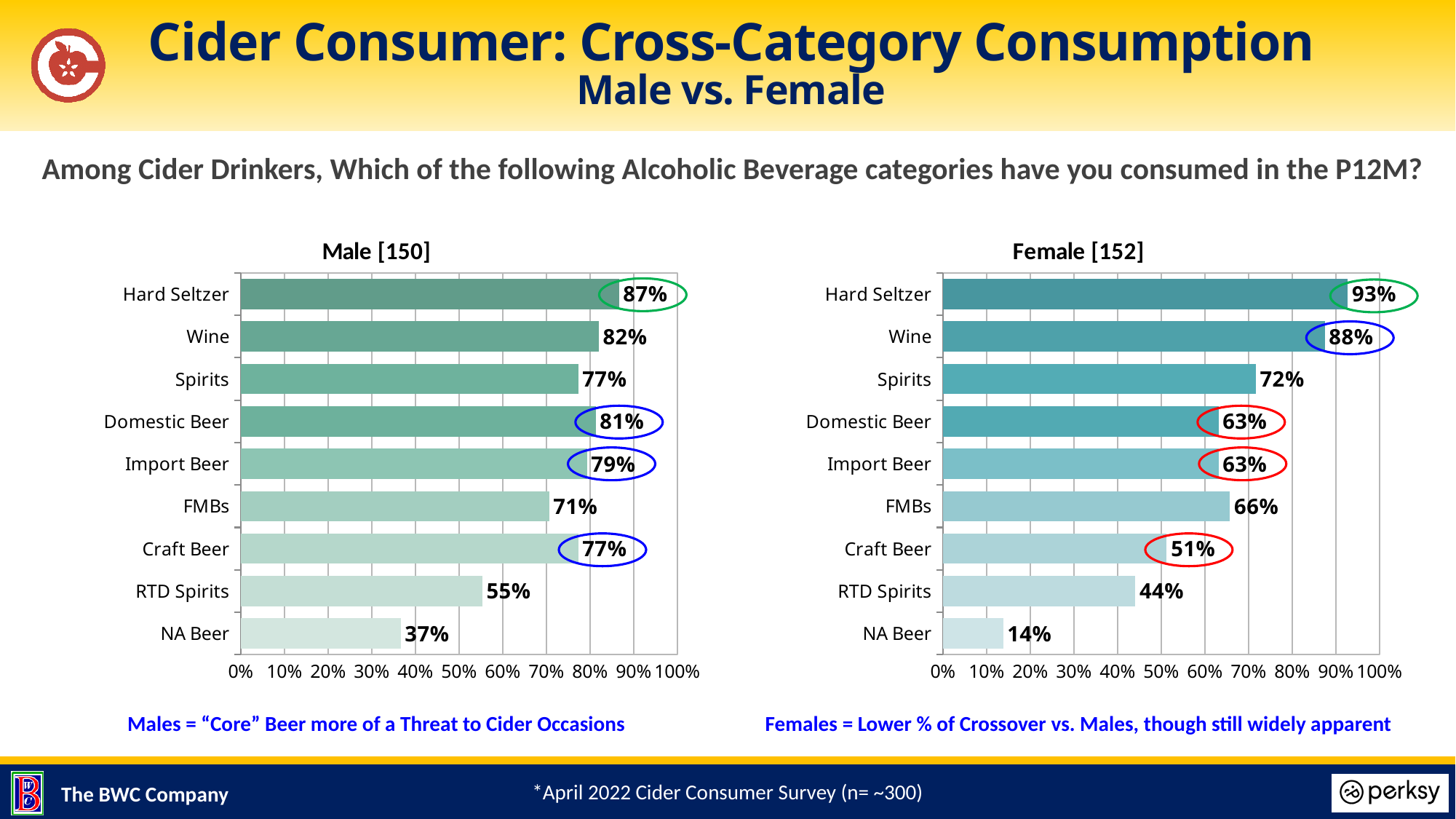
What type of chart is the Female [152] chart? bar chart In the Male [150] chart, what is the value for RTD Spirits? 55% In the Female [152] chart, what is the value for NA Beer? 14% In the Female [152] chart, which category has the lowest value? NA Beer In the Female [152] chart, is the value for RTD Spirits greater or less than 50%? less In the Male [150] chart, what is the difference between Hard Seltzer and NA Beer? 50% In the Male [150] chart, what is the value for Wine? 82% In the Male [150] chart, which category has the highest value? Hard Seltzer How many categories are shown in the Male [150] chart? 9 In the Female [152] chart, what is the value for FMBs? 66% In the Female [152] chart, what is the difference between Wine and Spirits? 16% Which is larger: Craft Beer in the Male [150] chart or Craft Beer in the Female [152] chart? Male [150]